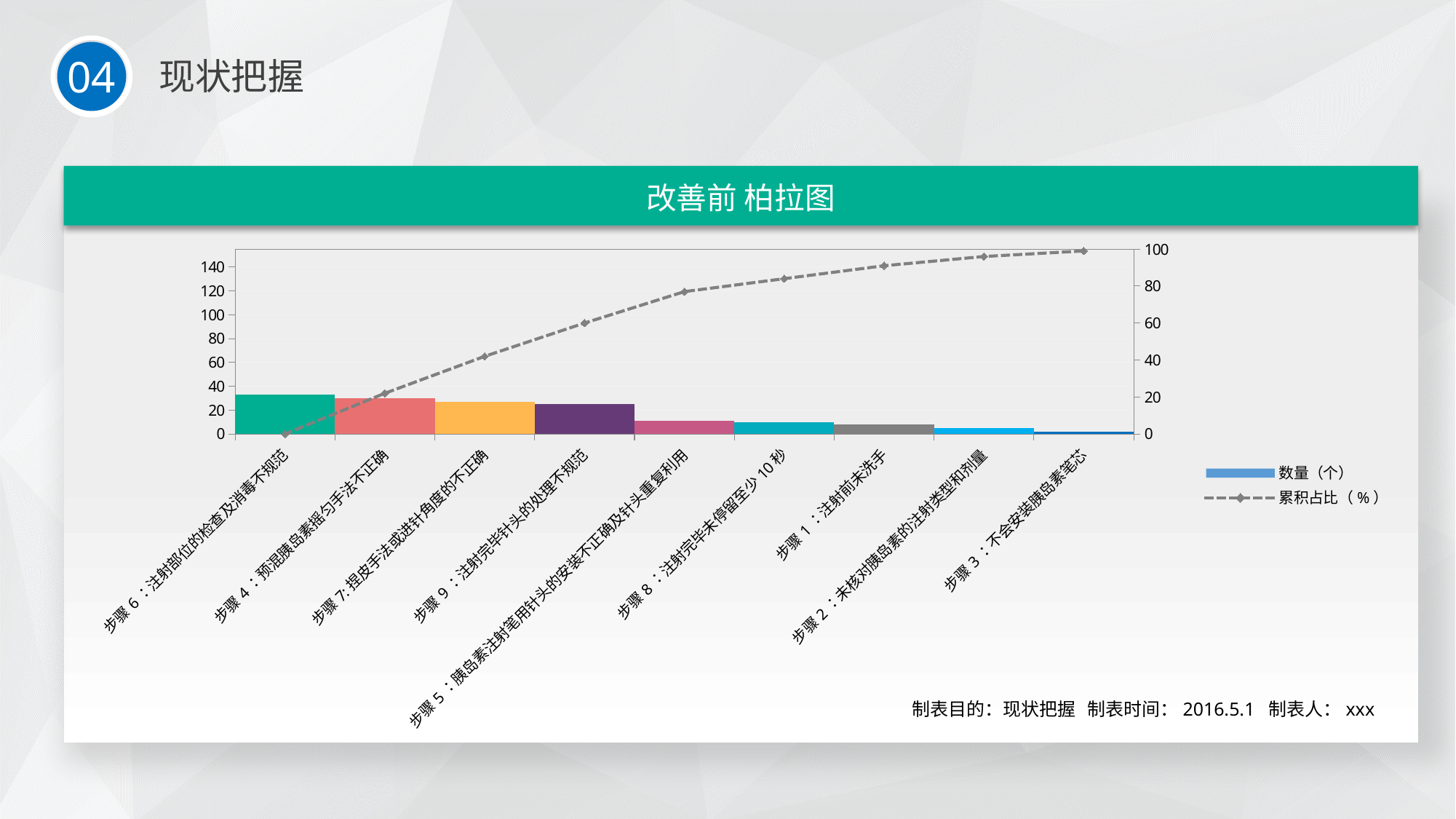
Does the 累积占比（%） line rise or fall from left to right? rise Which category has the highest bar in the chart? 步骤 6：注射部位的检查及消毒不规范 Which has the larger bar value: 步骤 4：预混胰岛素摇匀手法不正确 or 步骤 1：注射前未洗手? 步骤 4：预混胰岛素摇匀手法不正确 How many series does the chart legend list? 2 What are the two series named in the chart legend? 数量（个） and 累积占比（%） Is the bar value for 步骤 3：不会安装胰岛素笔芯 greater or less than 20? less Do the bar values rise or fall from left to right along the x axis? fall Is the bar value for 步骤 6：注射部位的检查及消毒不规范 greater or less than 20? greater How many categories (steps) are plotted along the x axis of the chart? 9 Is the bar value for 步骤 8：注射完毕未停留至少 10 秒 greater or less than 20? less Which category has the lowest bar in the chart? 步骤 3：不会安装胰岛素笔芯 What is the title of the chart on the slide? 改善前 柏拉图